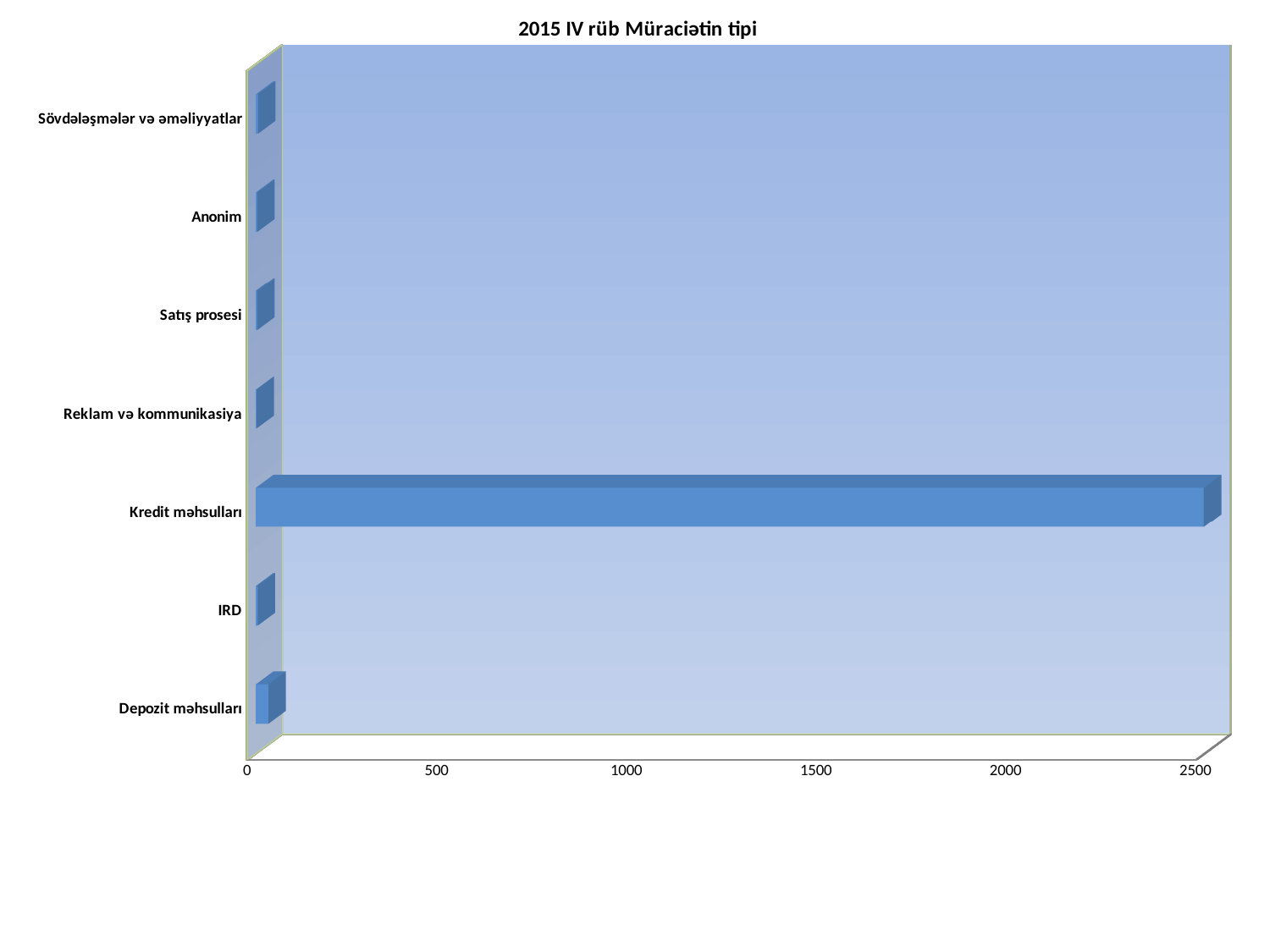
Is the value for Anonim greater or less than 500? less Which is larger, the value for Kredit məhsulları or the value for IRD? Kredit məhsulları Which category has the highest value? Kredit məhsulları What is the title of the chart? 2015 IV rüb Müraciətin tipi What kind of chart is shown on the slide? bar chart Is the value for Depozit məhsulları greater or less than 500? less Is the value for Satış prosesi greater or less than 1000? less How many categories are shown on the chart? 7 What is the highest value shown on the horizontal axis? 2500 Which is larger, the value for Reklam və kommunikasiya or the value for Kredit məhsulları? Kredit məhsulları